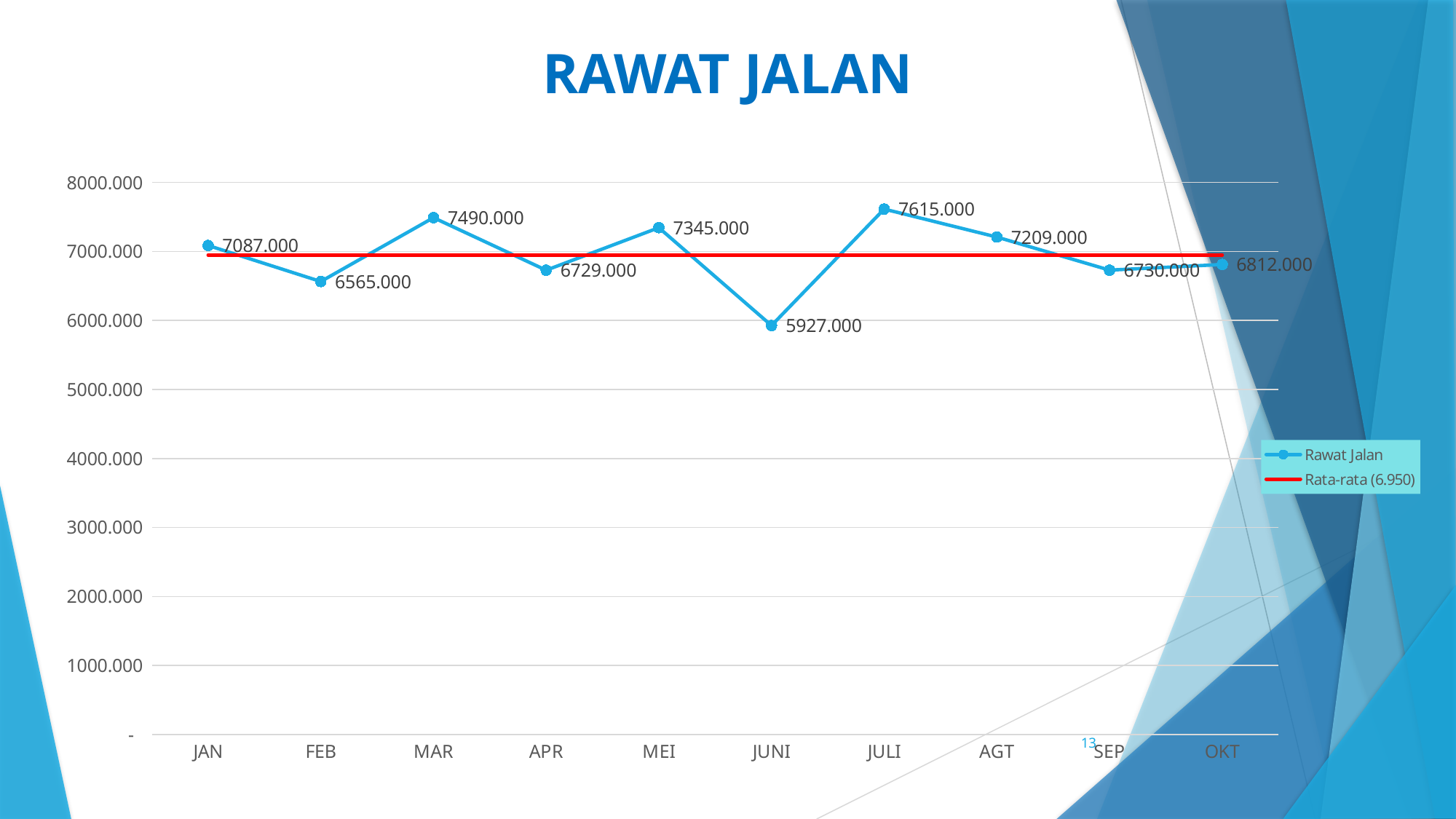
Which month has the highest Rawat Jalan value? JULI Which is larger, the Rawat Jalan value for FEB or for APR? APR How many months are plotted on the x axis of the chart? 10 What is the value for JUNI in the Rawat Jalan chart? 5927.000 What is the value for OKT in the Rawat Jalan chart? 6812.000 What kind of chart is shown on the slide? line chart Is the Rawat Jalan value for MEI greater or less than 7000.000? greater What is the difference between the Rawat Jalan values for JULI and JUNI? 1688.000 Which month has the lowest Rawat Jalan value? JUNI What is the value for MAR in the Rawat Jalan chart? 7490.000 How many series does the legend list? 2 What is the label of the red line series in the legend? Rata-rata (6.950)